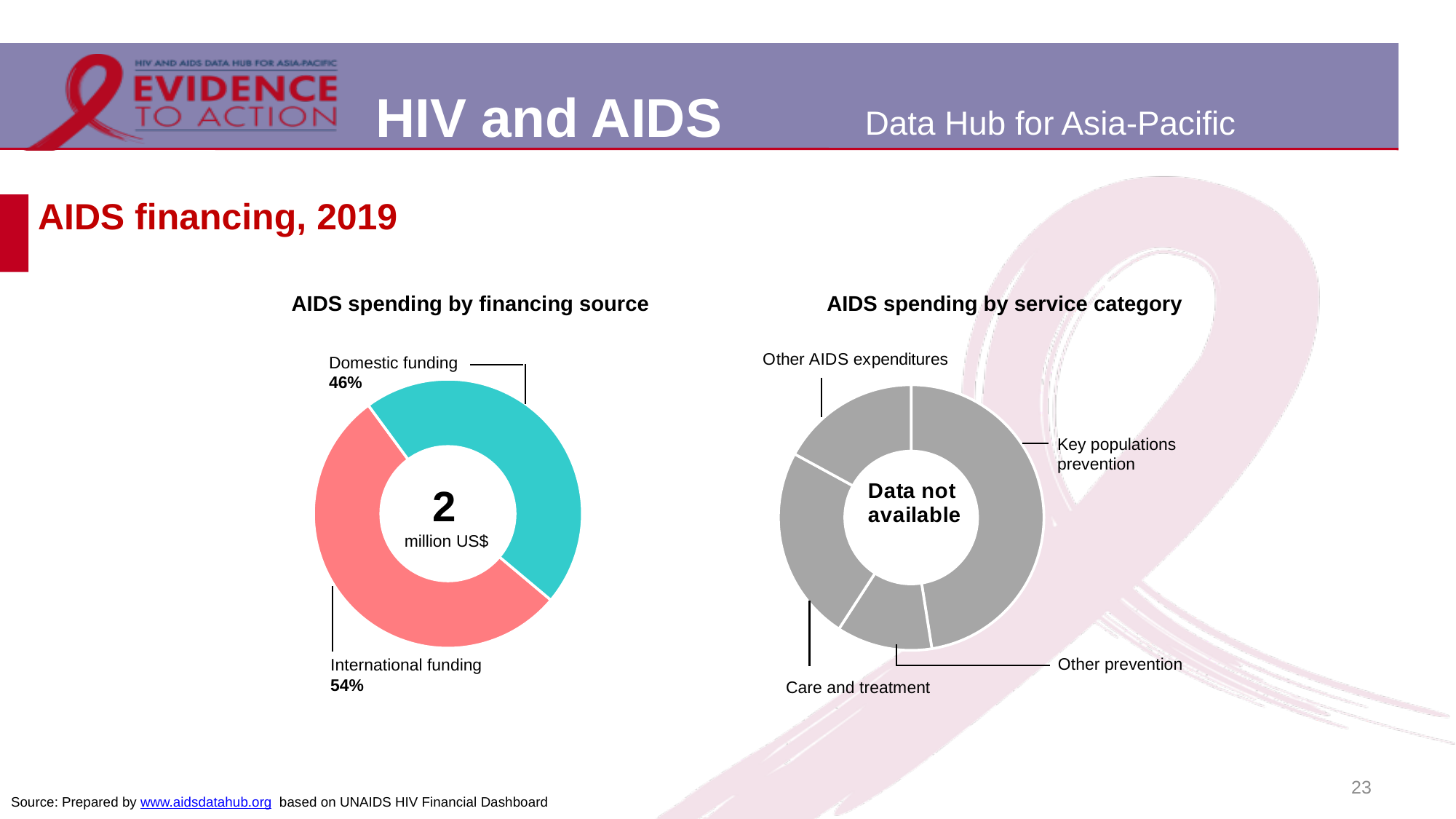
In the 'AIDS spending by financing source' chart, how many financing sources are shown? 2 In the 'AIDS spending by service category' chart, how many service categories are labelled? 4 What text appears in the centre of the 'AIDS spending by service category' chart? Data not available In the 'AIDS spending by financing source' chart, what share is International funding? 54% In the 'AIDS spending by financing source' chart, which financing source has the larger share? International funding In the 'AIDS spending by financing source' chart, which financing source has the smaller share? Domestic funding In the 'AIDS spending by financing source' chart, what total amount is shown in the centre of the donut? 2 million US$ What kind of chart is 'AIDS spending by financing source'? Donut (pie) chart In the 'AIDS spending by financing source' chart, is the share for Domestic funding greater or less than 50%? less In the 'AIDS spending by financing source' chart, what colour is the Domestic funding segment? Teal In the 'AIDS spending by financing source' chart, what is the difference in percentage points between International funding and Domestic funding? 8 percentage points In the 'AIDS spending by financing source' chart, what share is Domestic funding? 46%